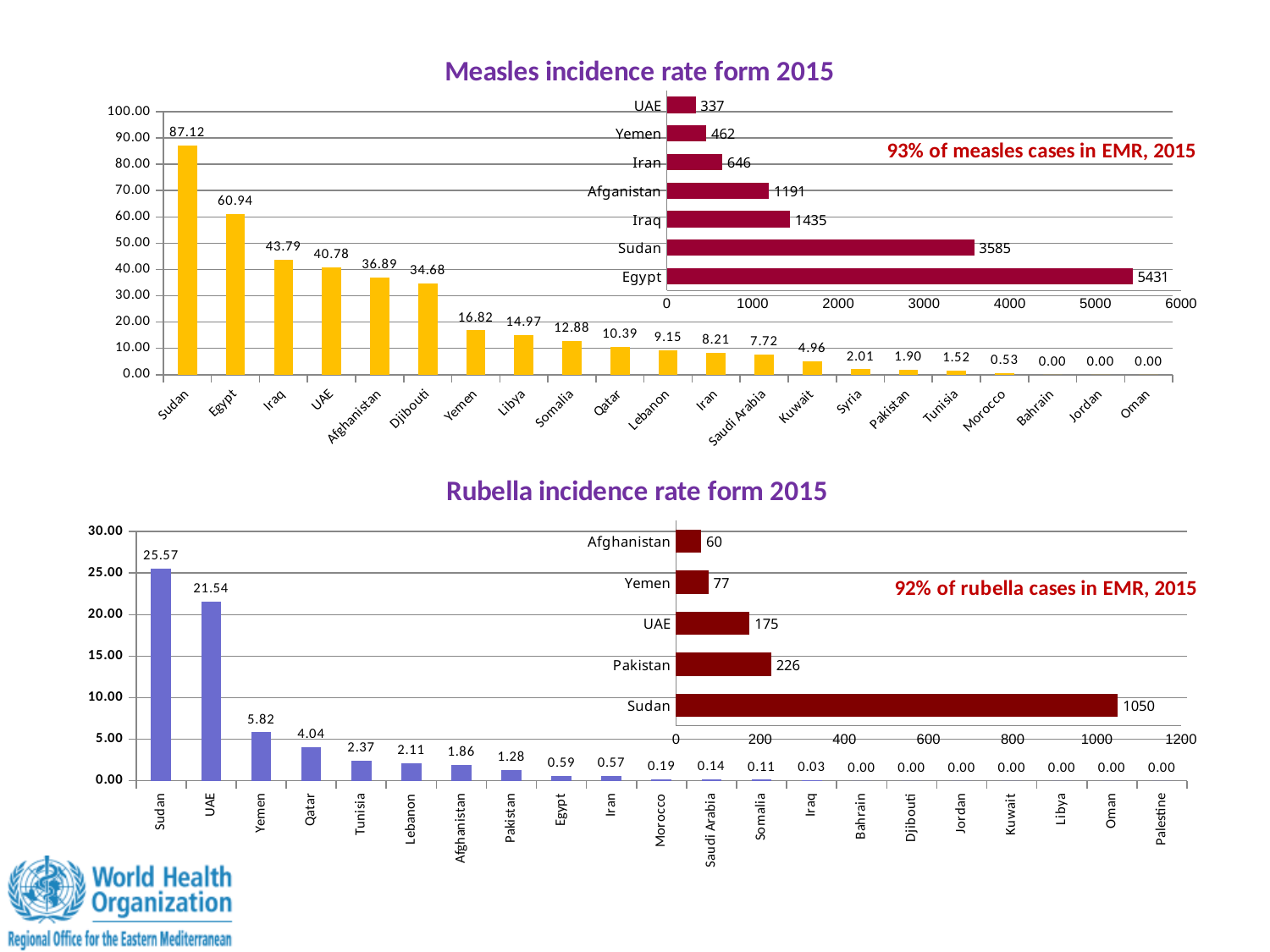
In the 'Measles incidence rate form 2015' chart, what is the value for Djibouti? 34.68 In the 'Measles incidence rate form 2015' chart, what is the difference between the values for Sudan and Egypt? 26.18 In the inset horizontal bar chart of measles cases (top chart), how many cases are shown for Egypt? 5431 In the 'Rubella incidence rate form 2015' chart, which is larger, the value for Yemen or the value for Qatar? Yemen In the 'Measles incidence rate form 2015' chart, what is the value for Sudan? 87.12 What type of chart is the 'Rubella incidence rate form 2015' chart? Bar chart In the inset horizontal bar chart of rubella cases (bottom chart), how many cases are shown for Sudan? 1050 In the 'Rubella incidence rate form 2015' chart, how many countries are shown on the x axis? 21 In the 'Measles incidence rate form 2015' chart, which country has the highest incidence rate? Sudan In the inset horizontal bar chart of measles cases (top chart), which country has the fewest cases? UAE In the inset horizontal bar chart of measles cases (top chart), how many countries are listed? 7 In the 'Rubella incidence rate form 2015' chart, what is the value for UAE? 21.54